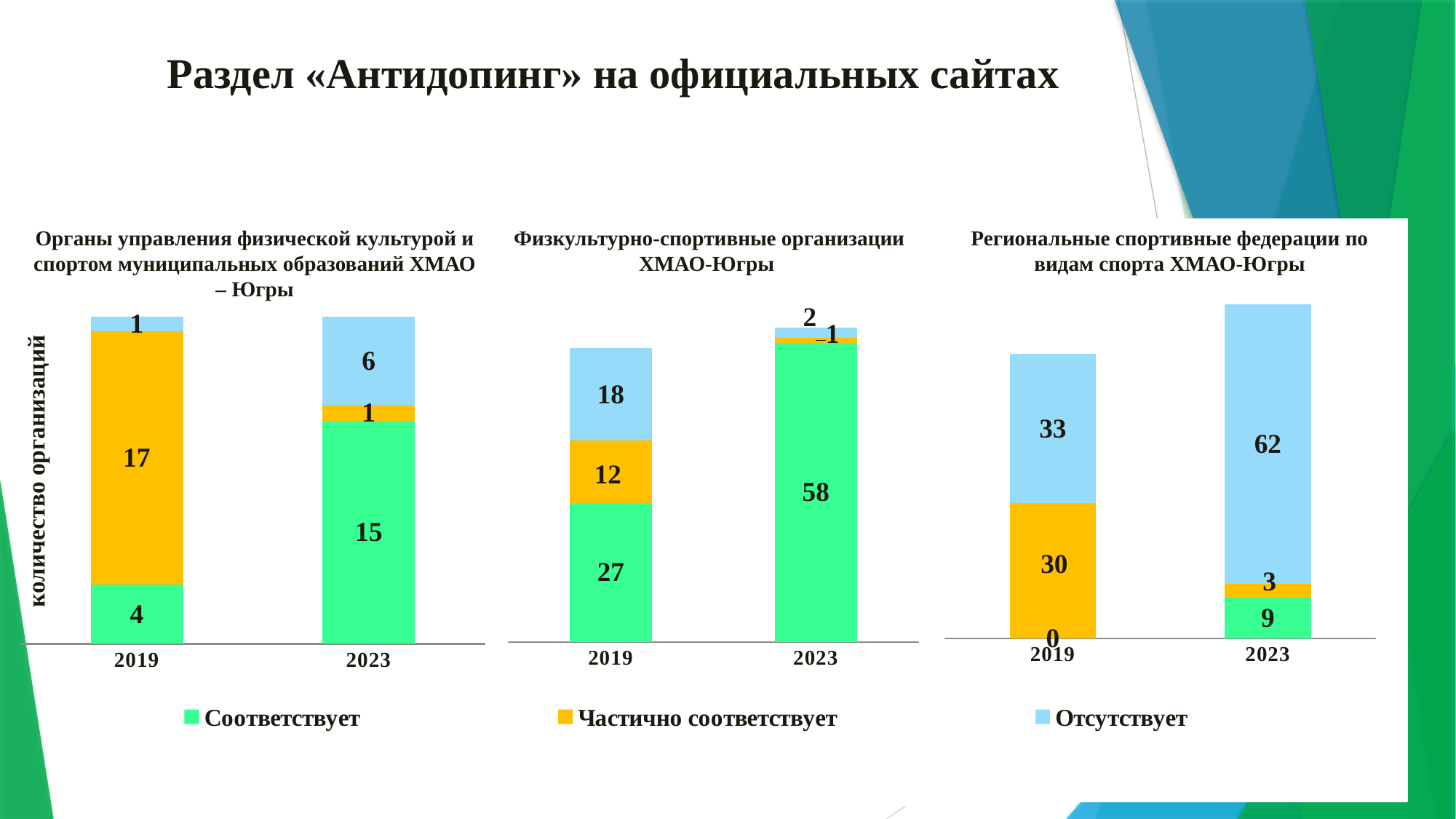
What kind of chart is the right chart (Региональные спортивные федерации по видам спорта ХМАО-Югры)? Stacked bar chart How many series does the legend list? 3 In the middle chart (Физкультурно-спортивные организации ХМАО-Югры), what is the value for Отсутствует in 2019? 18 In the left chart (Органы управления физической культурой и спортом муниципальных образований ХМАО – Югры), what is the value for Соответствует in 2023? 15 In the right chart (Региональные спортивные федерации по видам спорта ХМАО-Югры), what is the total of the stacked bar for 2023? 74 In the middle chart (Физкультурно-спортивные организации ХМАО-Югры), what is the value for Соответствует in 2023? 58 In the left chart (Органы управления физической культурой и спортом муниципальных образований ХМАО – Югры), what is the value for Частично соответствует in 2019? 17 In the right chart (Региональные спортивные федерации по видам спорта ХМАО-Югры), what is the value for Отсутствует in 2023? 62 In the middle chart (Физкультурно-спортивные организации ХМАО-Югры), which is larger: Соответствует in 2019 or Соответствует in 2023? 2023 In the right chart (Региональные спортивные федерации по видам спорта ХМАО-Югры), what is the value for Соответствует in 2019? 0 In the middle chart (Физкультурно-спортивные организации ХМАО-Югры), what is the total of the stacked bar for 2019? 57 In the left chart (Органы управления физической культурой и спортом муниципальных образований ХМАО – Югры), what is the difference between the Соответствует values for 2023 and 2019? 11